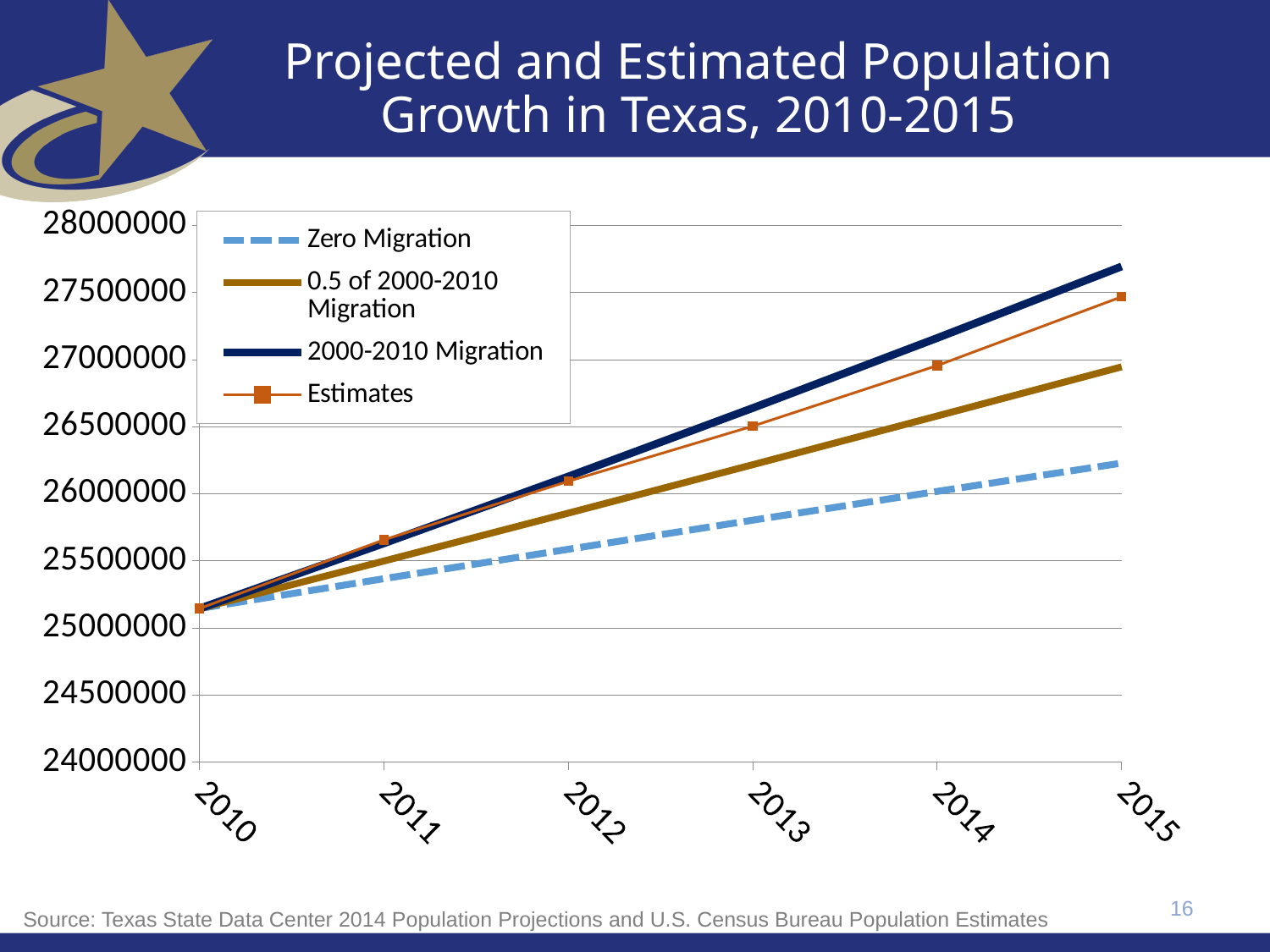
Is the value for Zero Migration in 2015 greater or less than 26000000? greater How many years are shown along the x axis? 6 Which series is drawn with a dashed line? Zero Migration Which series has the highest value in 2015? 2000-2010 Migration In 2015, which is larger: Estimates or 0.5 of 2000-2010 Migration? Estimates Do the values for the Estimates series rise or fall from 2010 to 2015? rise Which series has the lowest value in 2015? Zero Migration Is the value for Estimates in 2012 greater or less than 26000000? greater Is the value for Zero Migration in 2013 greater or less than 25500000? greater What kind of chart is shown on the slide? line chart How many series does the legend list? 4